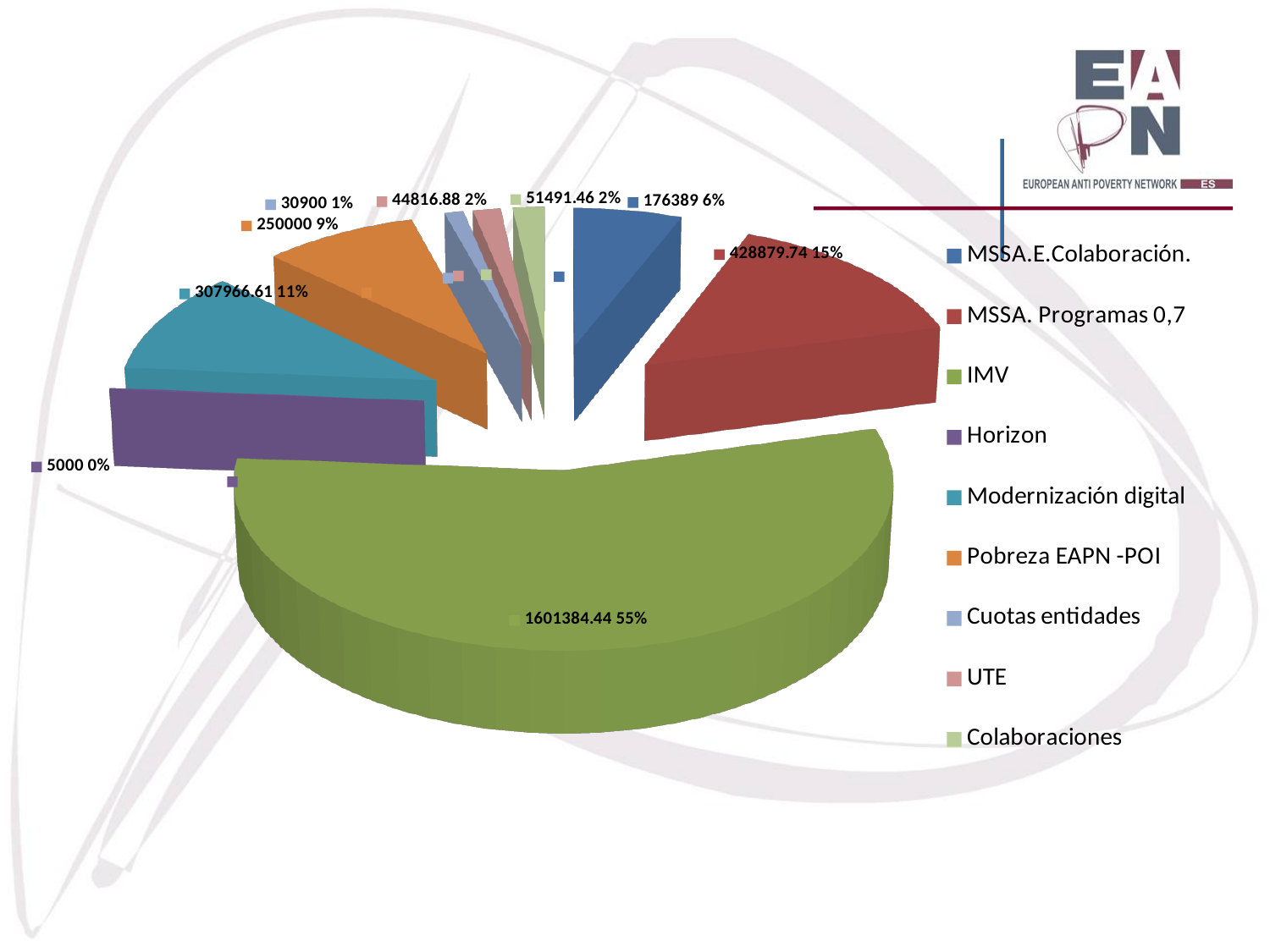
Which is larger, MSSA.E.Colaboración. or Pobreza EAPN -POI? Pobreza EAPN -POI How many slices does the pie chart have? 9 What is the difference between the values for Pobreza EAPN -POI and MSSA.E.Colaboración.? 73611 How many entries does the legend list? 9 What share of the pie does Modernización digital represent? 11% What value is shown for Pobreza EAPN -POI? 250000 Which category has the largest slice? IMV What value is shown for IMV? 1601384.44 Which category has the smallest slice? Horizon What share of the pie does IMV represent? 55% What value is shown for MSSA. Programas 0,7? 428879.74 What kind of chart is shown on the slide? Pie chart